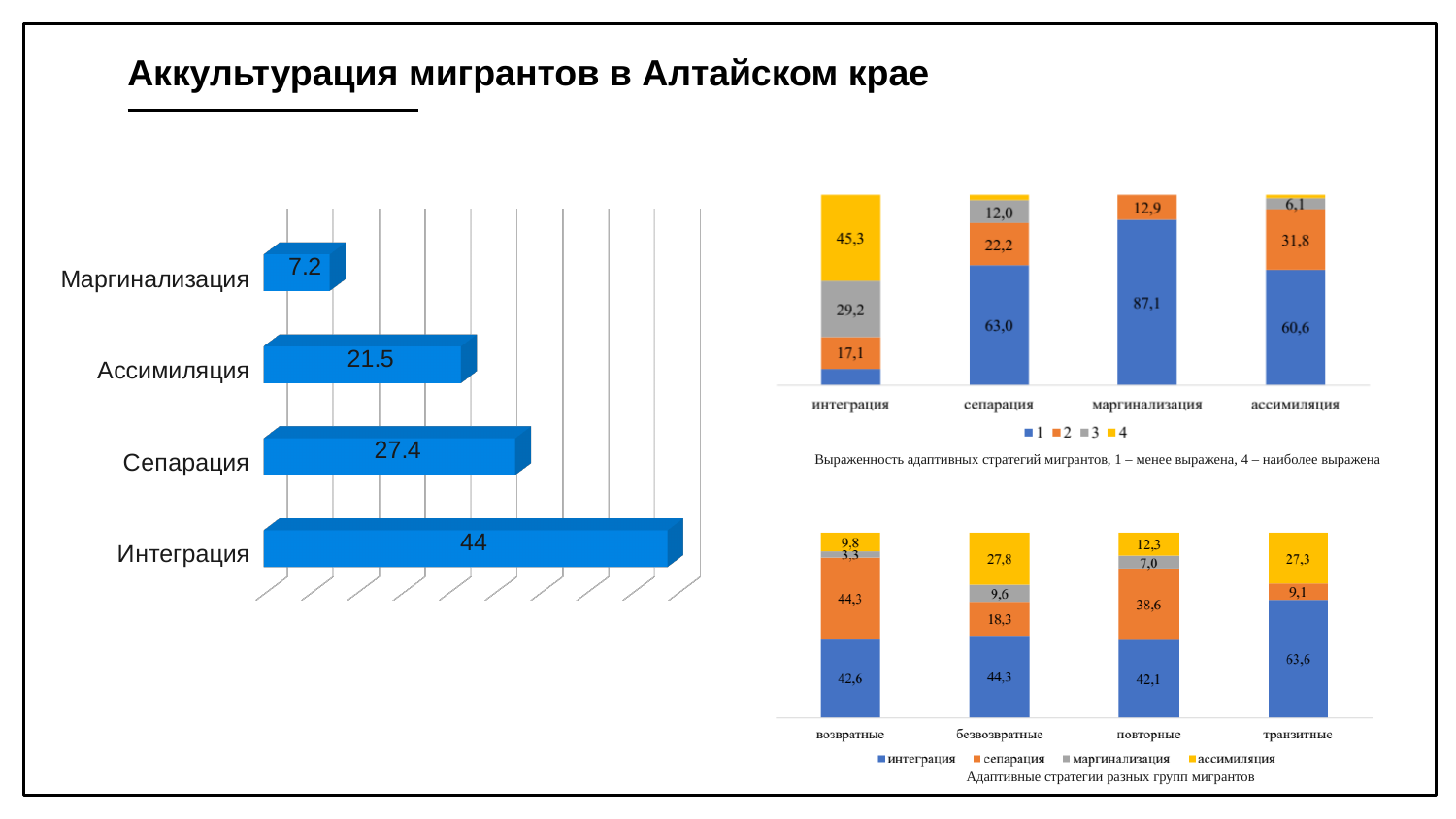
In the left bar chart, how many categories are shown? 4 What kind of chart is the chart on the left of the slide? Bar chart In the left bar chart, what is the difference between the values for Интеграция and Сепарация? 16.6 In the top-right chart 'Выраженность адаптивных стратегий мигрантов', what is the value of series 4 for интеграция? 45,3 In the left bar chart, what is the value for Интеграция? 44 In the left bar chart, which category has the highest value? Интеграция In the left bar chart, what is the value for Маргинализация? 7.2 In the bottom-right chart 'Адаптивные стратегии разных групп мигрантов', which group has the larger value for сепарация: возвратные or повторные? возвратные In the top-right chart 'Выраженность адаптивных стратегий мигрантов', how many series does the legend list? 4 In the top-right chart 'Выраженность адаптивных стратегий мигрантов', what is the value of series 1 for маргинализация? 87,1 In the left bar chart, which category has the lowest value? Маргинализация In the bottom-right chart 'Адаптивные стратегии разных групп мигрантов', what is the value of интеграция for транзитные? 63,6